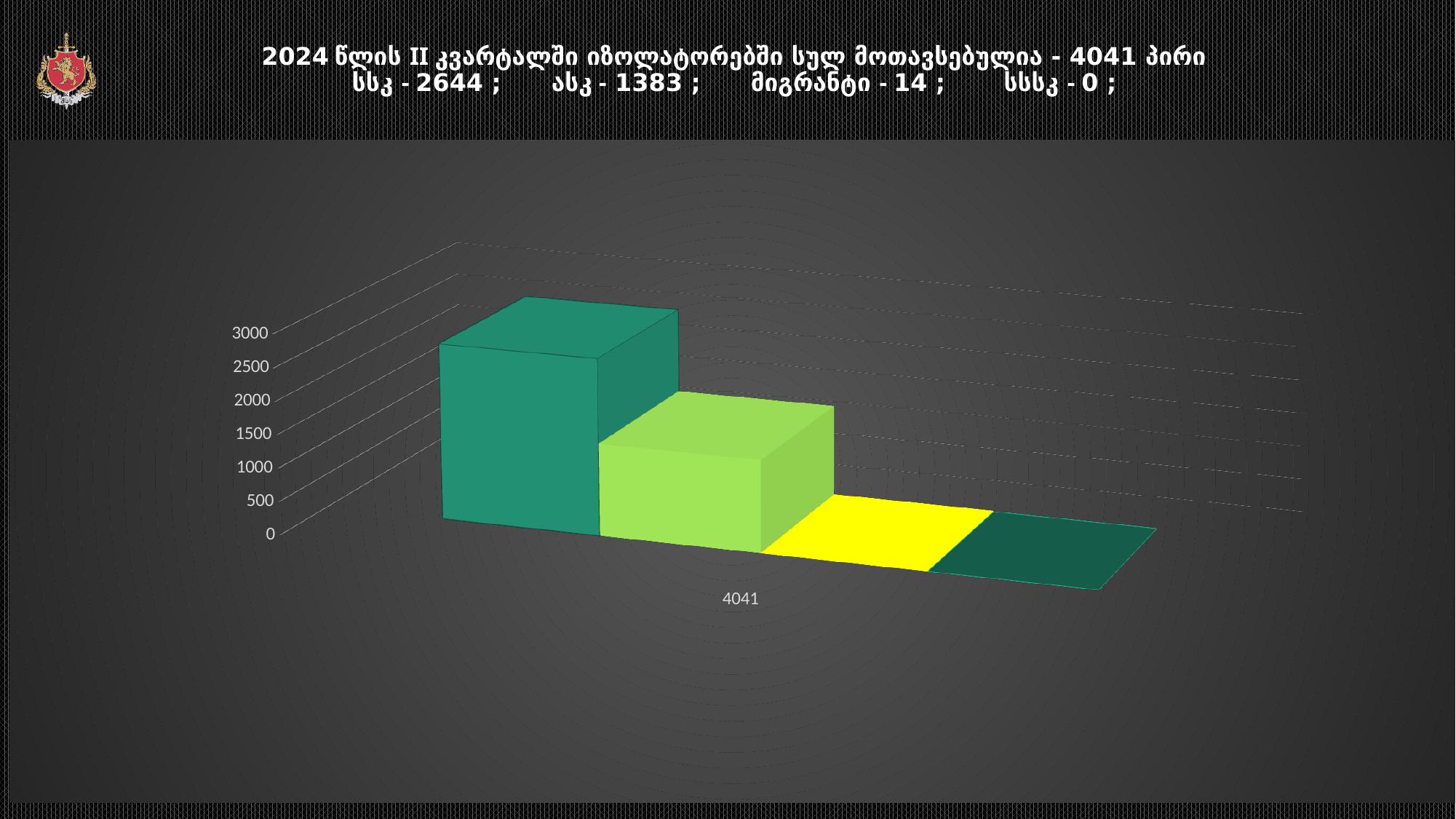
Is the value of the leftmost teal bar greater or less than 2000? greater Is the value of the leftmost teal bar greater or less than 1500? greater Is the value of the light green bar (second from left) greater or less than 2000? less What kind of chart is shown on the slide? bar chart Which bar in the chart is the tallest? the leftmost teal bar What is the highest tick value shown on the vertical axis of the chart? 3000 Do the bar values rise or fall from left to right across the chart? fall Which is larger, the leftmost teal bar or the light green bar next to it? the leftmost teal bar How many bars are plotted in the chart? 4